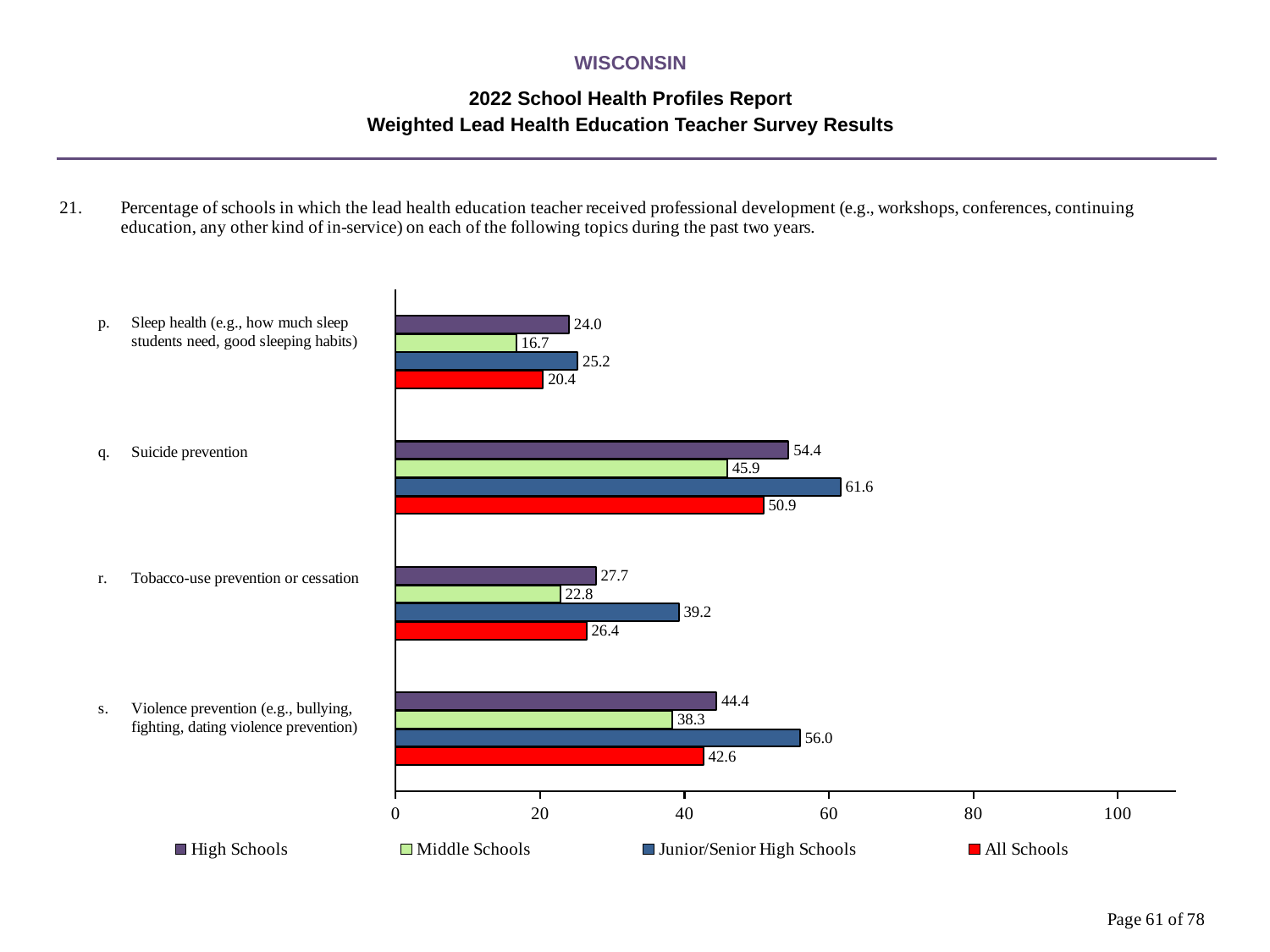
What is the value for All Schools on Violence prevention? 42.6 Which topic has the lowest value for Middle Schools? Sleep health How many topics are shown on the chart? 4 What is the value for High Schools on Suicide prevention? 54.4 What is the value for Middle Schools on Sleep health? 16.7 What is the value for Junior/Senior High Schools on Tobacco-use prevention or cessation? 39.2 Which is larger on Violence prevention: High Schools or Middle Schools? High Schools Which topic has the highest value for All Schools? Suicide prevention What kind of chart is shown on the slide? Bar chart What is the difference between the Junior/Senior High Schools and Middle Schools values on Suicide prevention? 15.7 How many series does the legend list? 4 Is the value for Junior/Senior High Schools on Suicide prevention greater or less than 60? greater